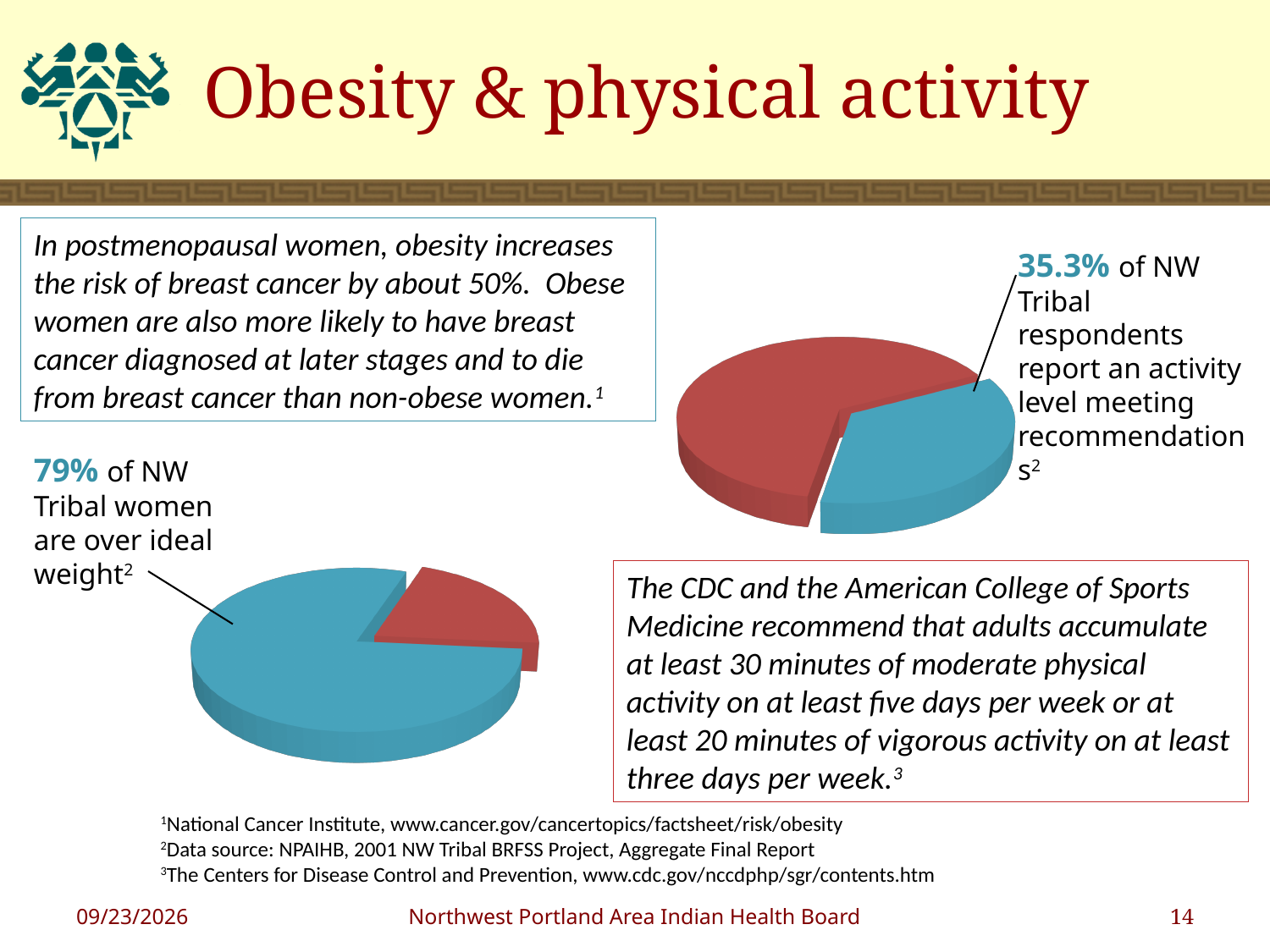
In the lower-left pie chart, what colour is the slice representing the 79% of NW Tribal women who are over ideal weight? blue In the upper-right pie chart, what share of NW Tribal respondents report an activity level meeting recommendations? 35.3% In the lower-left pie chart, is the share of NW Tribal women over ideal weight greater or less than 50%? greater In the upper-right pie chart, is the share of respondents meeting activity recommendations greater or less than 50%? less In the upper-right pie chart, which slice is larger, the red one or the blue one? red In the upper-right pie chart, what colour is the slice representing the 35.3% of respondents meeting activity recommendations? blue What kind of chart is the chart in the upper right of the slide? pie chart In the lower-left pie chart, what share of NW Tribal women are over ideal weight? 79% In the lower-left pie chart, which slice is larger, the blue one or the red one? blue How many slices does the lower-left pie chart have? 2 What kind of chart is the chart in the lower left of the slide? pie chart How many slices does the upper-right pie chart have? 2